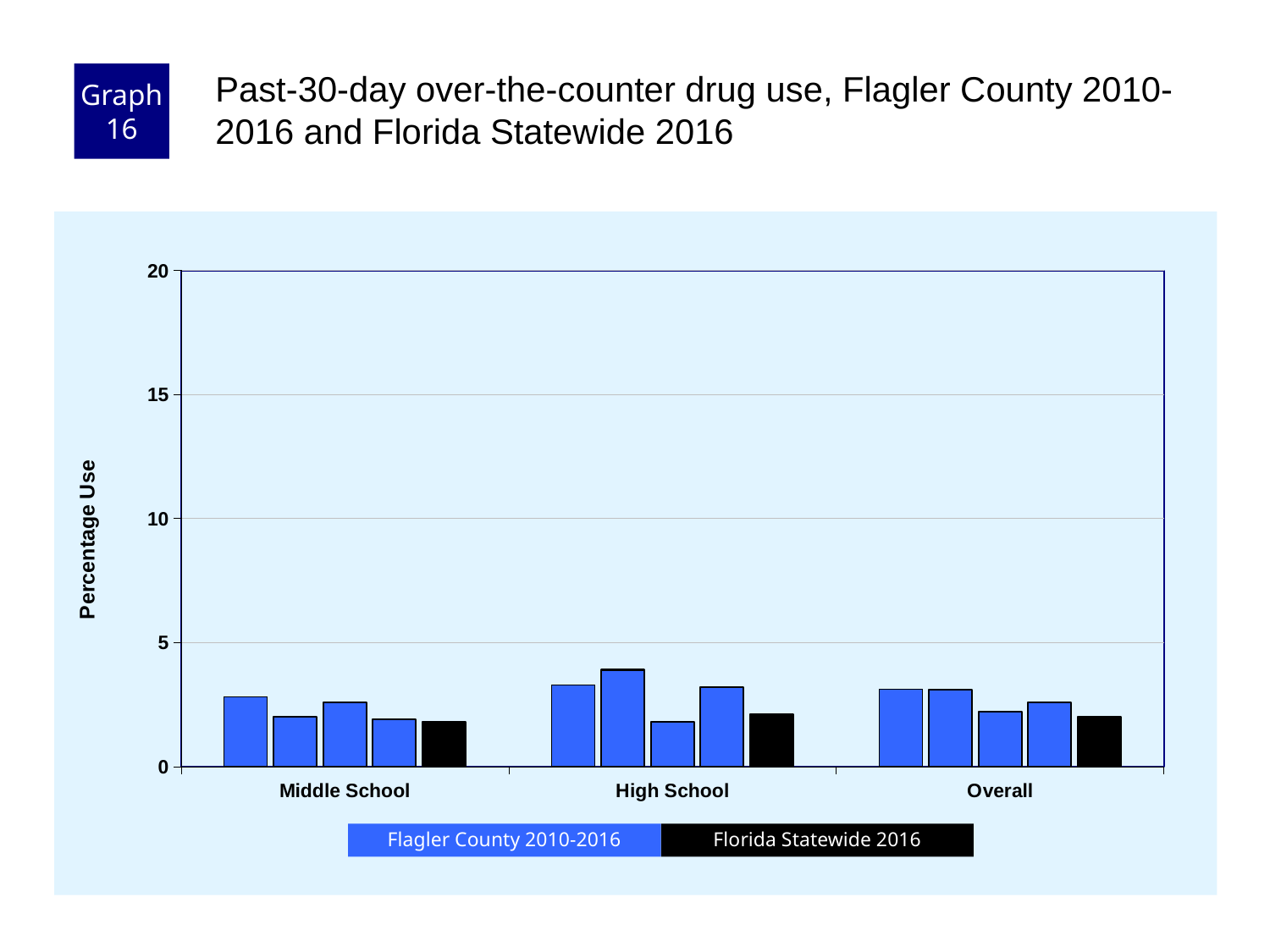
Is the Florida Statewide 2016 value for High School greater or less than 5? less Is the Florida Statewide 2016 value for Middle School greater or less than 5? less What is the highest value shown on the y axis? 20 Are any of the plotted values greater than 10? No Which category contains the tallest bar on the chart? High School What colour represents Florida Statewide 2016 in the legend? black How many series does the legend list? 2 How many bars are plotted in each category group? 5 What kind of chart is shown on the slide? bar chart How many categories are shown on the x axis? 3 What is the label of the y axis? Percentage Use In the High School group, is the tallest Flagler County 2010-2016 bar larger or smaller than the Florida Statewide 2016 bar? larger